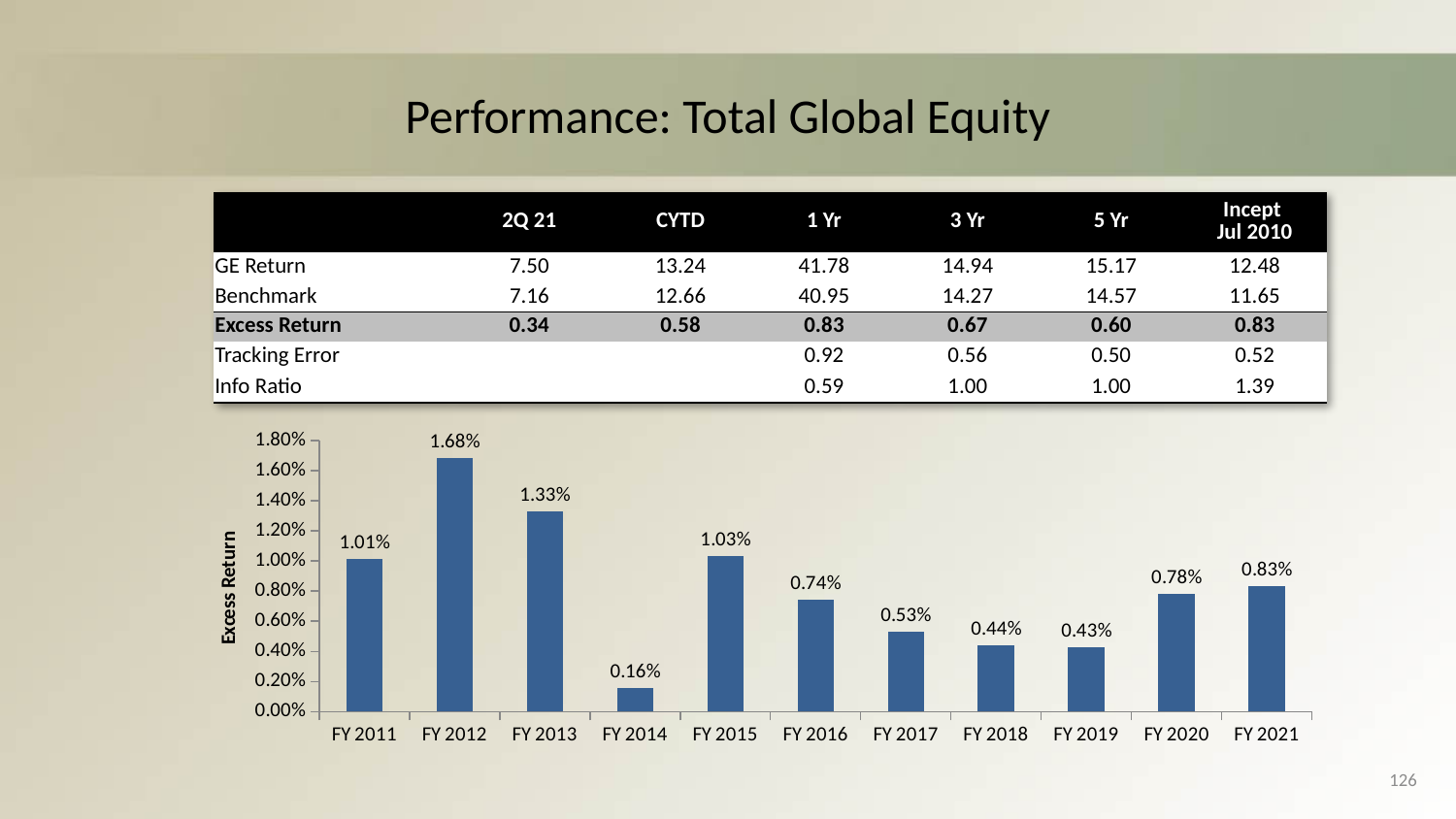
How many fiscal years are shown in the bar chart? 11 What is the label on the vertical axis of the bar chart? Excess Return Is the excess return for FY 2017 greater or less than 0.60%? less What is the difference between the excess return for FY 2012 and FY 2013? 0.35% Which fiscal year has the lowest excess return in the bar chart? FY 2014 What type of chart is shown on the slide? bar chart Which fiscal year has the highest excess return in the bar chart? FY 2012 What is the excess return for FY 2021 in the bar chart? 0.83% What is the excess return for FY 2012 in the bar chart? 1.68% Does the excess return rise or fall from FY 2015 to FY 2019? fall What is the excess return for FY 2014 in the bar chart? 0.16% Which has a larger excess return, FY 2015 or FY 2016? FY 2015